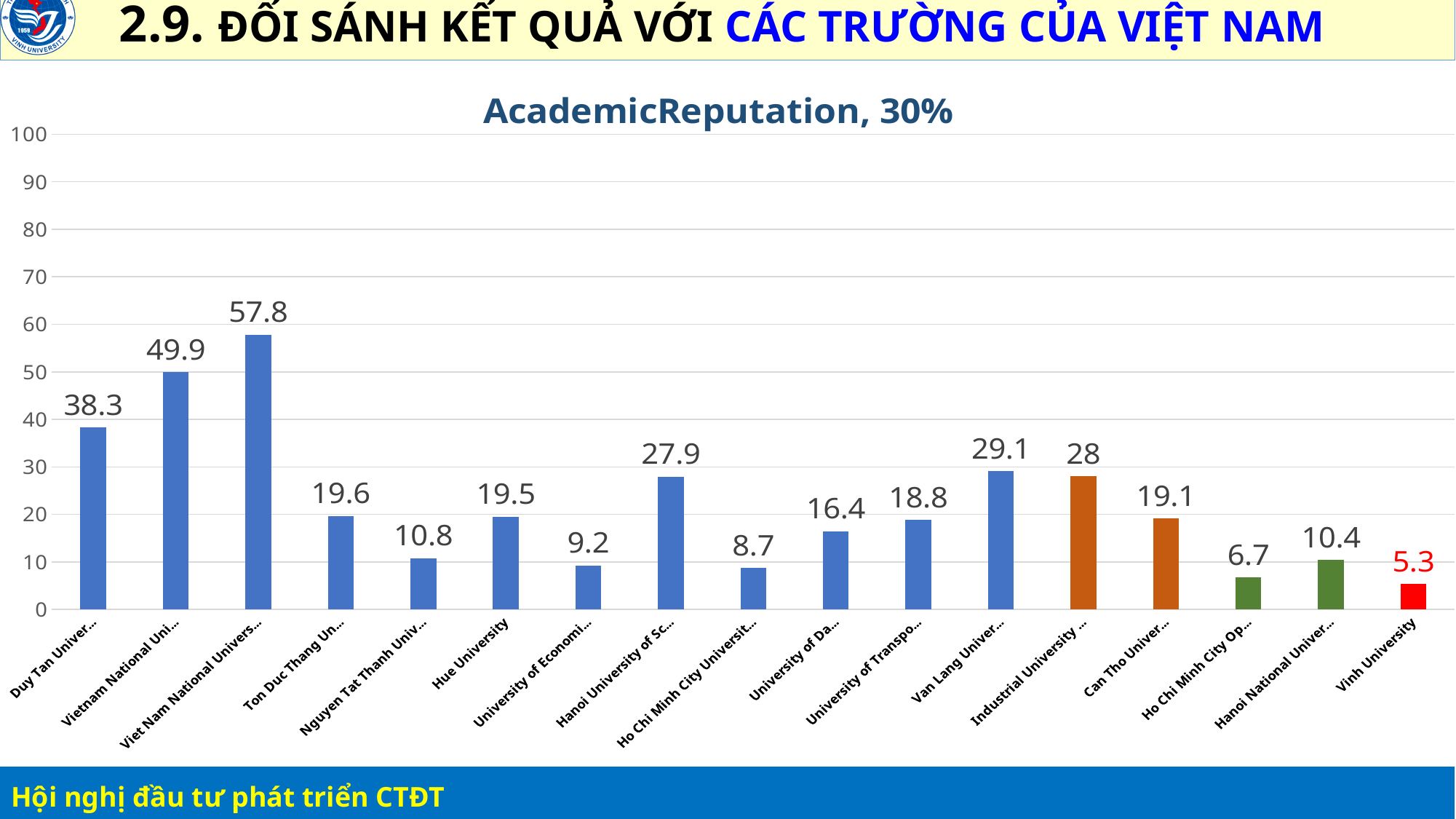
How many bars (universities) are shown in the chart? 17 What type of chart is shown on the slide? bar chart What is the highest value shown in the chart? 57.8 What colour is the bar for Vinh University? red Which is larger, the value for Van Lang University or the value for Can Tho University? Van Lang University What is the title of the chart? AcademicReputation, 30% Is the value for Duy Tan University greater or less than 30? greater What is the value for Duy Tan University? 38.3 What is the value for Vinh University? 5.3 Which university has the lowest value in the chart? Vinh University What is the value for Hue University? 19.5 What is the difference between the values for Hue University and Vinh University? 14.2